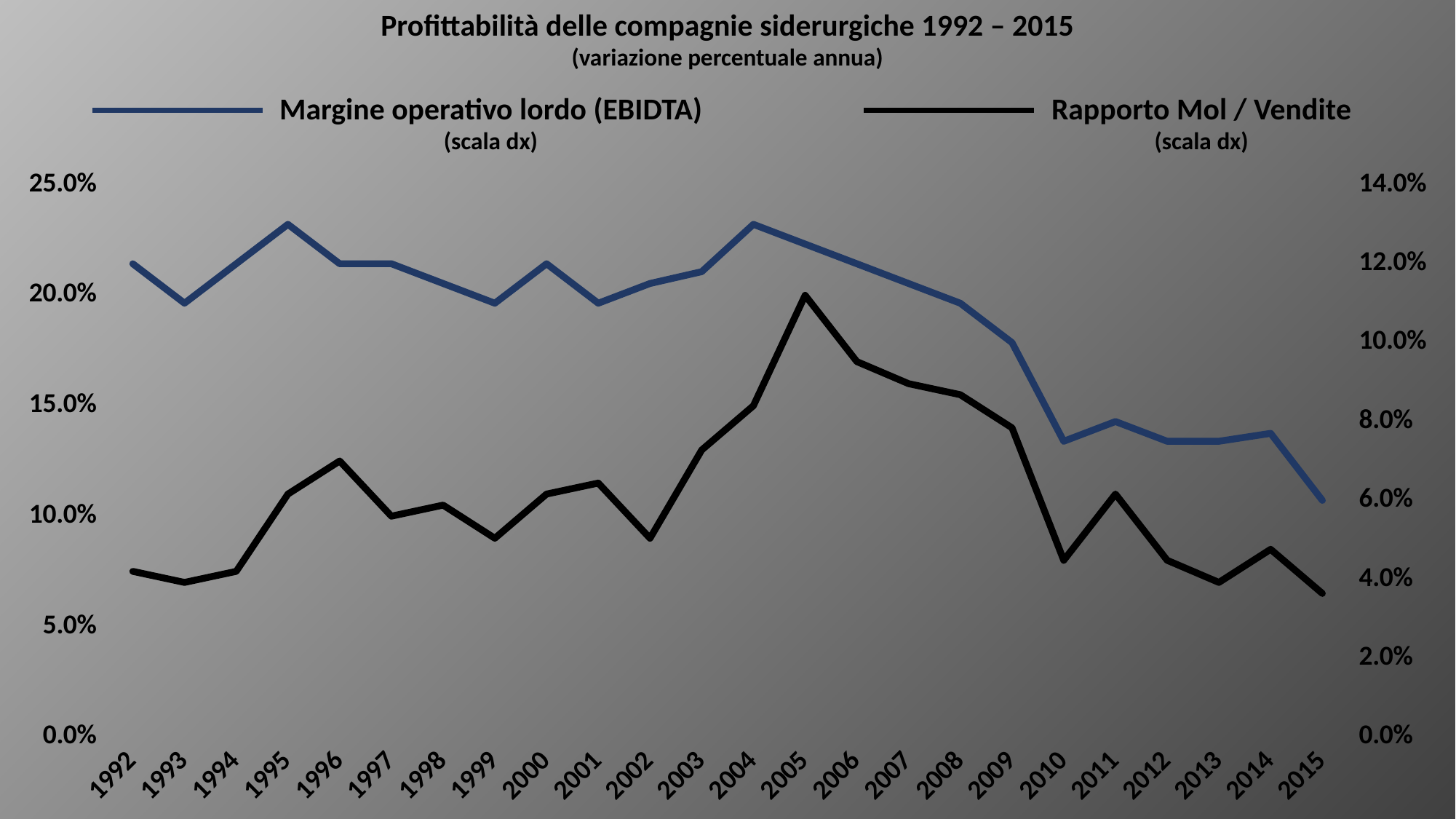
In which year does the Rapporto Mol / Vendite line reach its highest point? 2005 How many series does the legend list? 2 Which year has the higher Rapporto Mol / Vendite value, 2002 or 2005? 2005 What kind of chart is shown on the slide? Line chart What is the title of the chart? Profittabilità delle compagnie siderurgiche 1992 – 2015 Is the value for Rapporto Mol / Vendite in 2015 greater or less than 8.0%? less How many years are plotted along the x axis? 24 In which year does the Margine operativo lordo (EBIDTA) line reach its lowest point? 2015 Is the value for Rapporto Mol / Vendite in 2005 greater or less than 10.0%? greater Which year has the higher Margine operativo lordo (EBIDTA) value, 1995 or 2015? 1995 Does the Margine operativo lordo (EBIDTA) line rise or fall from 2004 to 2015? Fall Which series is drawn with the black line? Rapporto Mol / Vendite